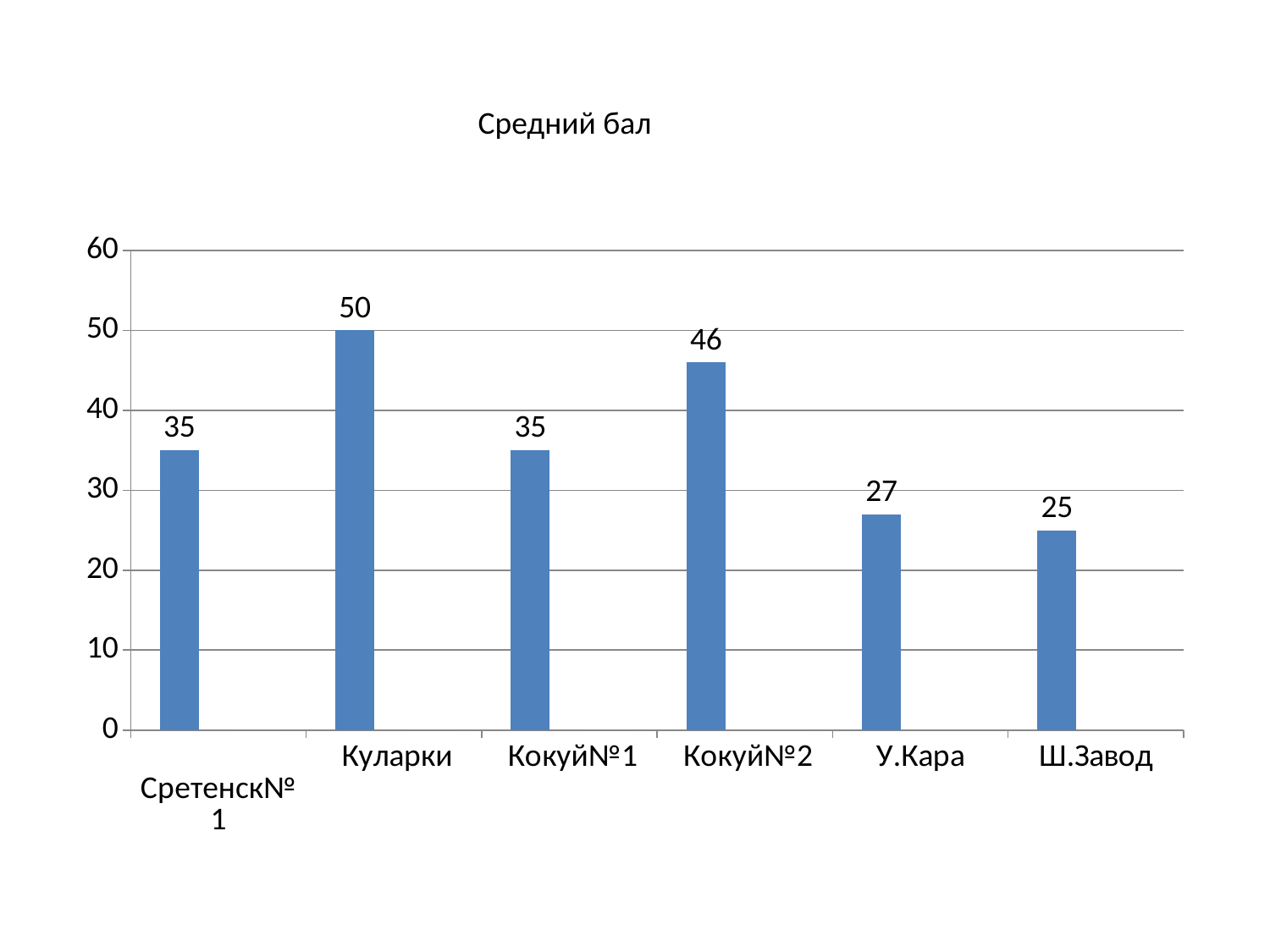
What kind of chart is this? bar chart How many categories are shown on the chart? 6 Which category has the highest value? Куларки What is the value for У.Кара? 27 What is the value for Ш.Завод? 25 What is the value for Кокуй№2? 46 What is the difference between the values for Сретенск№1 and Ш.Завод? 10 Which is larger, the value for Кокуй№2 or the value for Кокуй№1? Кокуй№2 What is the difference between the values for Куларки and Кокуй№2? 4 What is the title of the chart? Средний бал Which category has the lowest value? Ш.Завод What is the value for Куларки? 50